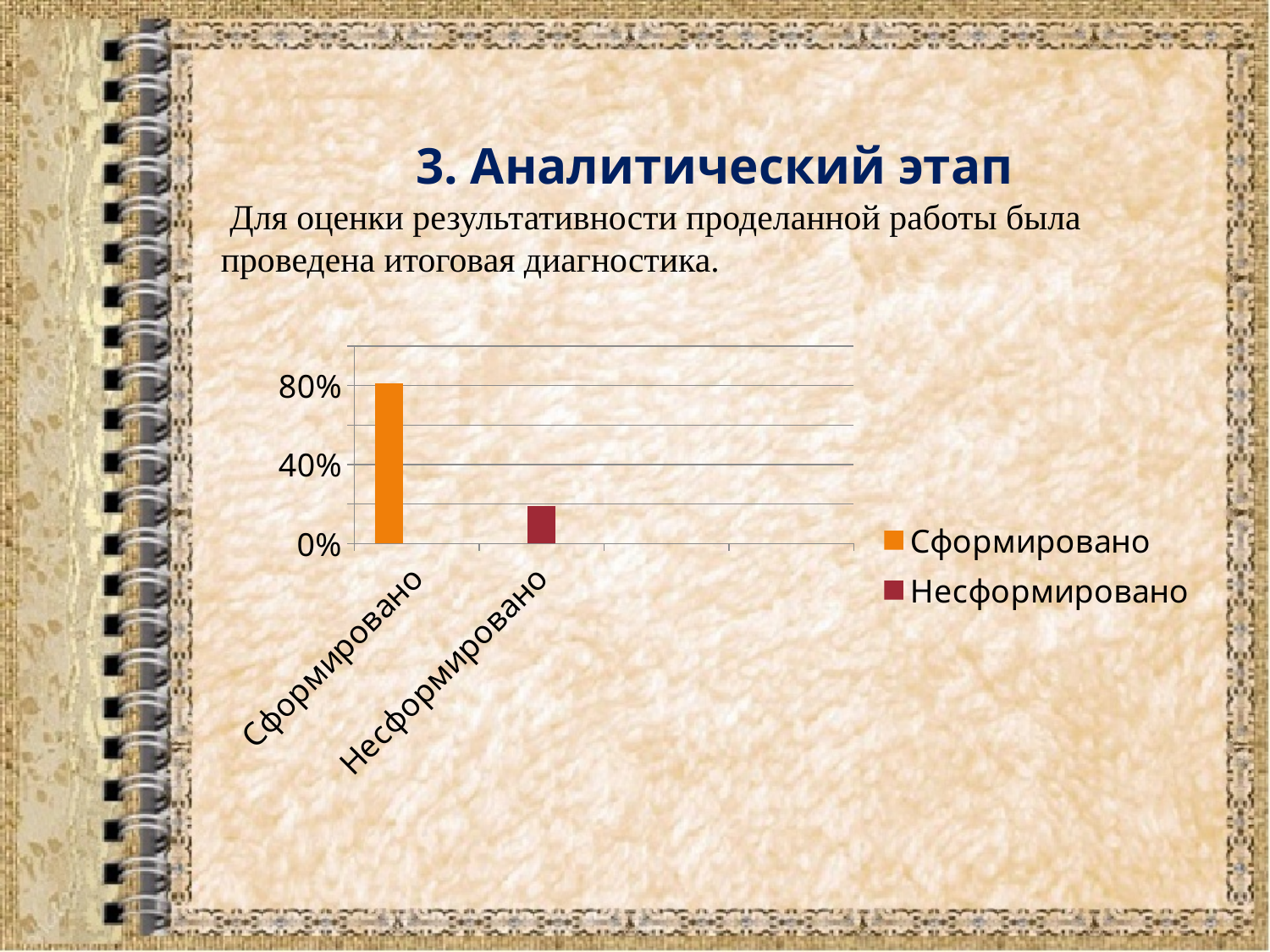
Which is larger, the value for Сформировано or the value for Несформировано? Сформировано What colour is the bar for Сформировано? orange How many categories are shown on the x axis of the chart? 2 Which category has the lowest bar in the chart? Несформировано Which category has the highest bar in the chart? Сформировано How many entries does the chart's legend list? 2 What kind of chart is shown on the slide? bar chart Is the value for Несформировано greater or less than 40%? less Is the value for Сформировано greater or less than 40%? greater What is the highest value labelled on the chart's vertical axis? 80%